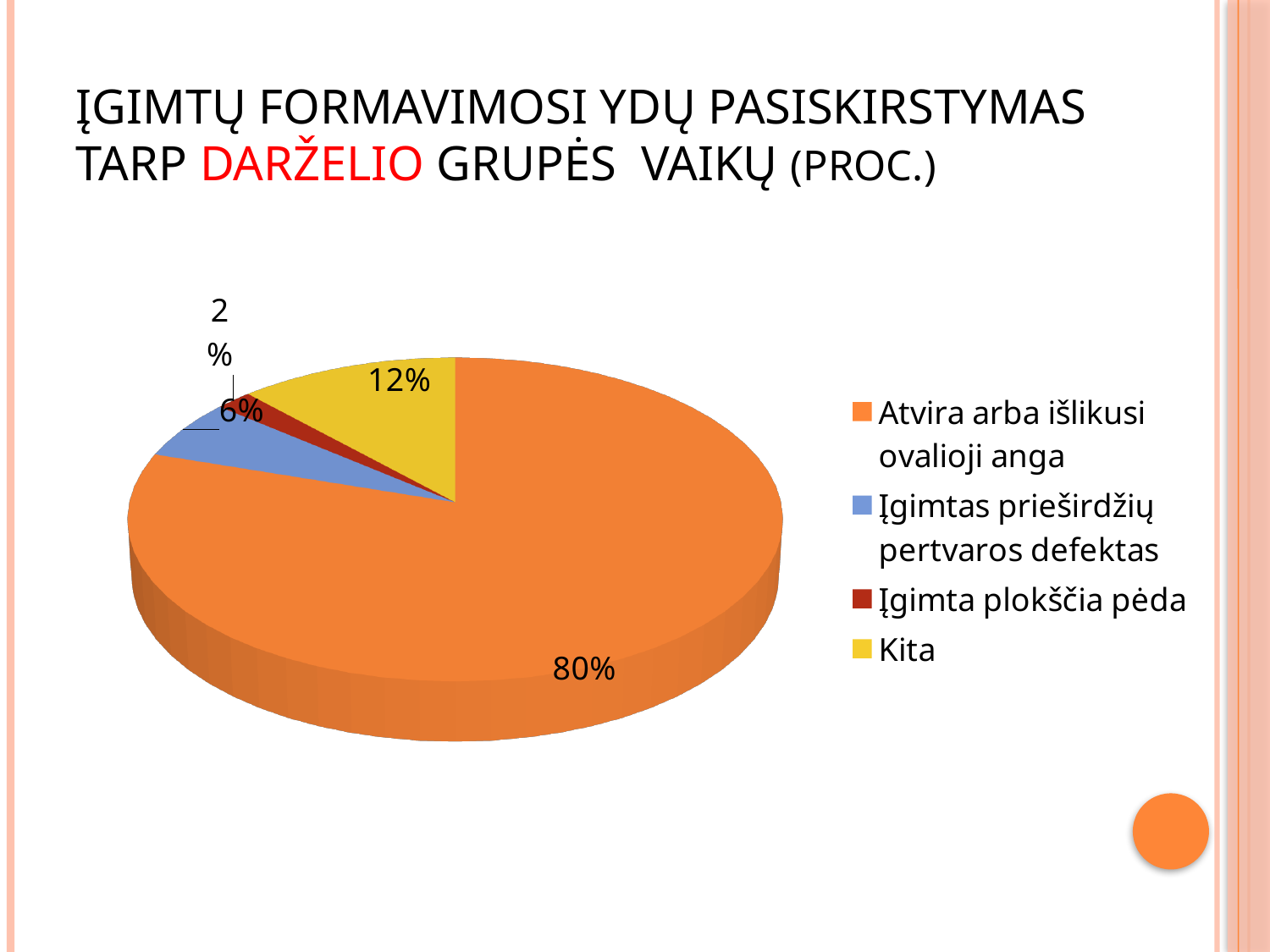
Which category has the largest slice of the pie? Atvira arba išlikusi ovalioji anga Which category has the smallest slice of the pie? Įgimta plokščia pėda What percentage is shown for 'Įgimta plokščia pėda'? 2% What percentage of the pie is labelled for 'Atvira arba išlikusi ovalioji anga'? 80% What is the difference in percentage points between 'Atvira arba išlikusi ovalioji anga' and 'Kita'? 68 What percentage is shown for 'Įgimtas prieširdžių pertvaros defektas'? 6% What colour is the slice for 'Kita'? Yellow Which is larger, the slice for 'Kita' or the slice for 'Įgimtas prieširdžių pertvaros defektas'? Kita What percentage is shown for 'Kita'? 12% What kind of chart is shown on the slide? Pie chart What is the difference in percentage points between 'Įgimtas prieširdžių pertvaros defektas' and 'Įgimta plokščia pėda'? 4 How many categories does the legend list? 4